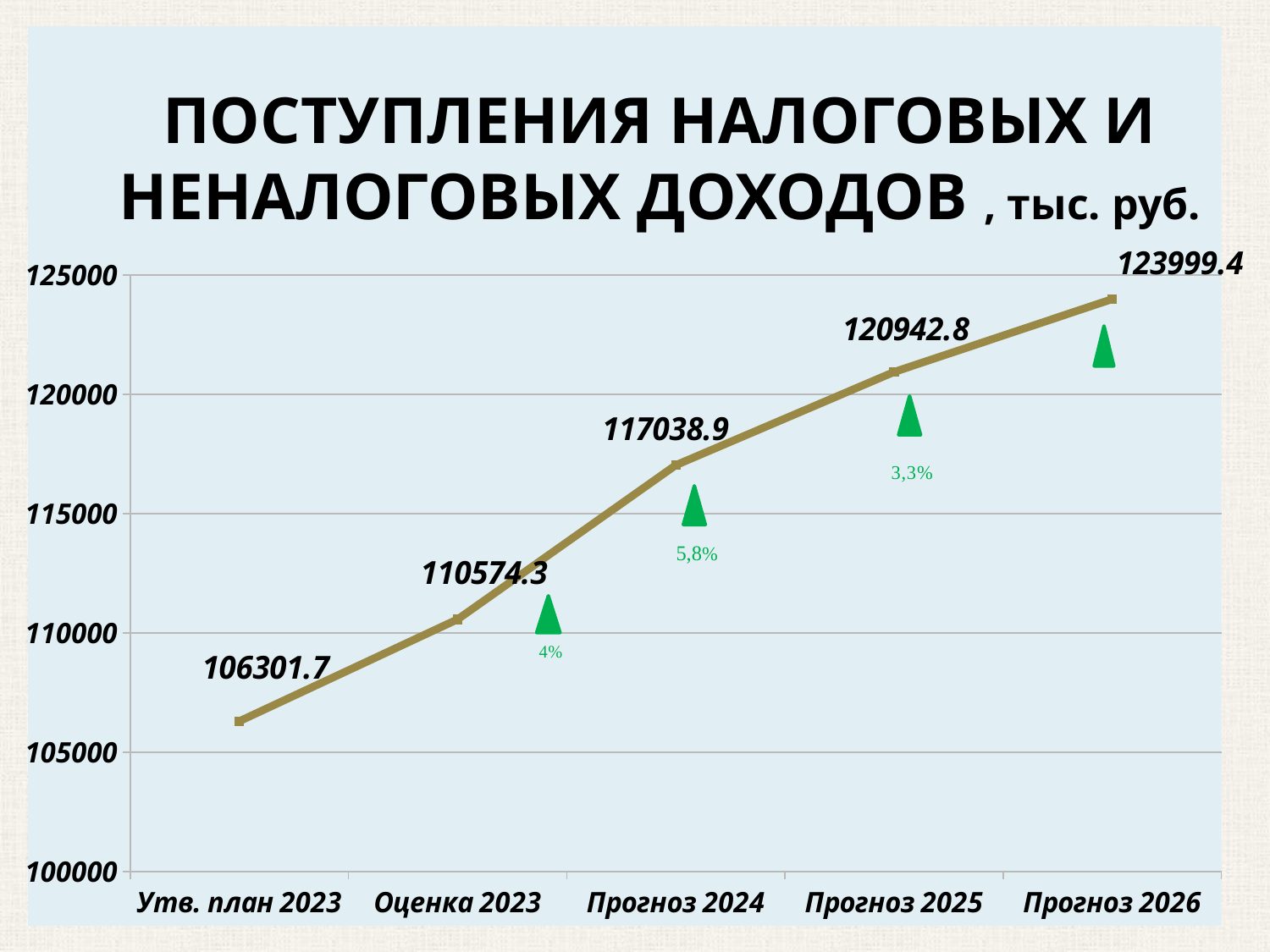
What kind of chart is shown on the slide? line chart How many data points are plotted on the chart? 5 Which category has the highest value? Прогноз 2026 What is the value for Утв. план 2023? 106301.7 Is the value for Оценка 2023 greater or less than 115000? less Which category has the lowest value? Утв. план 2023 What is the value for Прогноз 2026? 123999.4 Which is larger, the value for Прогноз 2025 or the value for Прогноз 2024? Прогноз 2025 What is the difference between the values for Оценка 2023 and Утв. план 2023? 4272.6 Do the values rise or fall from Утв. план 2023 to Прогноз 2026? rise What is the difference between the values for Прогноз 2026 and Прогноз 2025? 3056.6 What is the value for Прогноз 2024? 117038.9